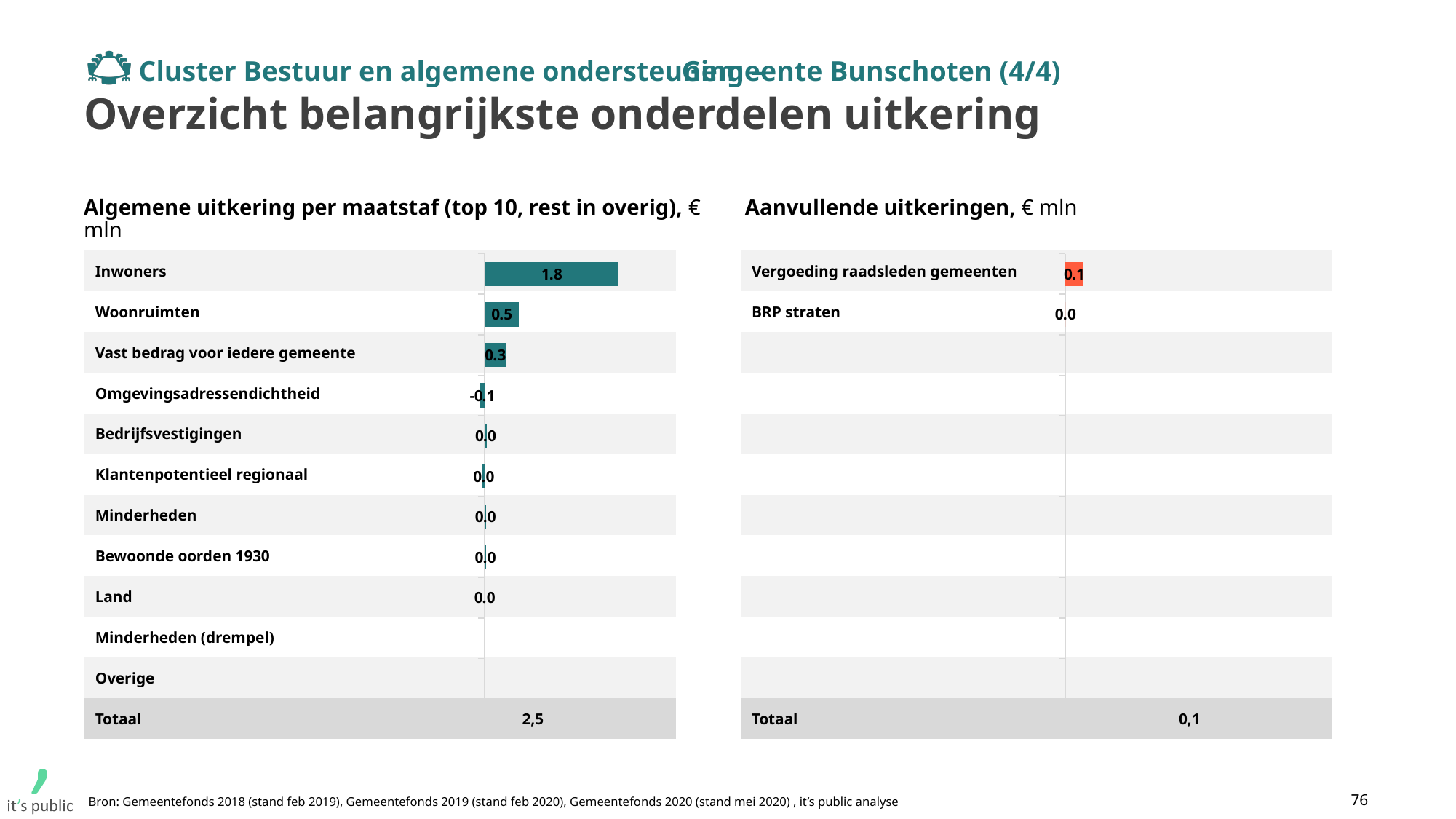
In the chart 'Aanvullende uitkeringen', what is the value for Vergoeding raadsleden gemeenten? 0.1 What kind of chart is the 'Aanvullende uitkeringen' chart on the right? Bar chart In the chart 'Algemene uitkering per maatstaf', which category has the lowest value? Omgevingsadressendichtheid In the chart 'Aanvullende uitkeringen', what is the value for BRP straten? 0.0 In the chart 'Algemene uitkering per maatstaf', what is the value for Inwoners? 1.8 In the chart 'Algemene uitkering per maatstaf', which category has the highest value? Inwoners In the chart 'Algemene uitkering per maatstaf', what is the Totaal value shown? 2,5 In the chart 'Algemene uitkering per maatstaf', what is the value for Vast bedrag voor iedere gemeente? 0.3 In the chart 'Algemene uitkering per maatstaf', what is the value for Omgevingsadressendichtheid? -0.1 In the chart 'Algemene uitkering per maatstaf', what is the value for Woonruimten? 0.5 In the chart 'Algemene uitkering per maatstaf', what is the difference between the values for Inwoners and Woonruimten? 1.3 In the chart 'Algemene uitkering per maatstaf', which is larger: Woonruimten or Vast bedrag voor iedere gemeente? Woonruimten